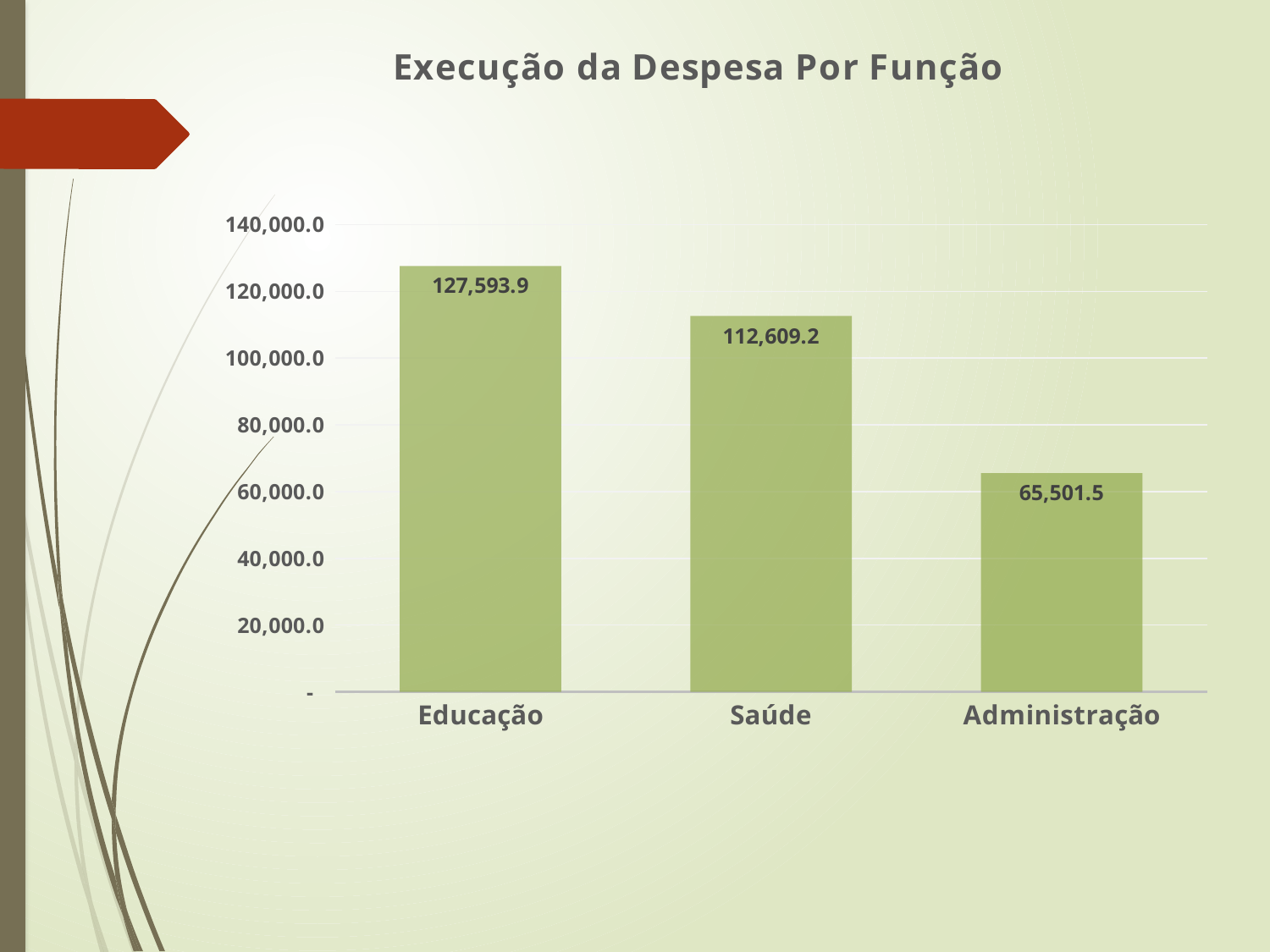
Is the value for Administração greater or less than 80,000.0? less What kind of chart is shown on the slide? bar chart What is the difference between the values for Saúde and Administração? 47,107.7 What is the title of the chart? Execução da Despesa Por Função Which category has the lowest value? Administração What is the value for Administração? 65,501.5 What is the difference between the values for Educação and Saúde? 14,984.7 Which is larger, the value for Saúde or the value for Administração? Saúde Which category has the highest value? Educação What is the value for Saúde? 112,609.2 What is the value for Educação? 127,593.9 How many categories are shown on the x axis? 3